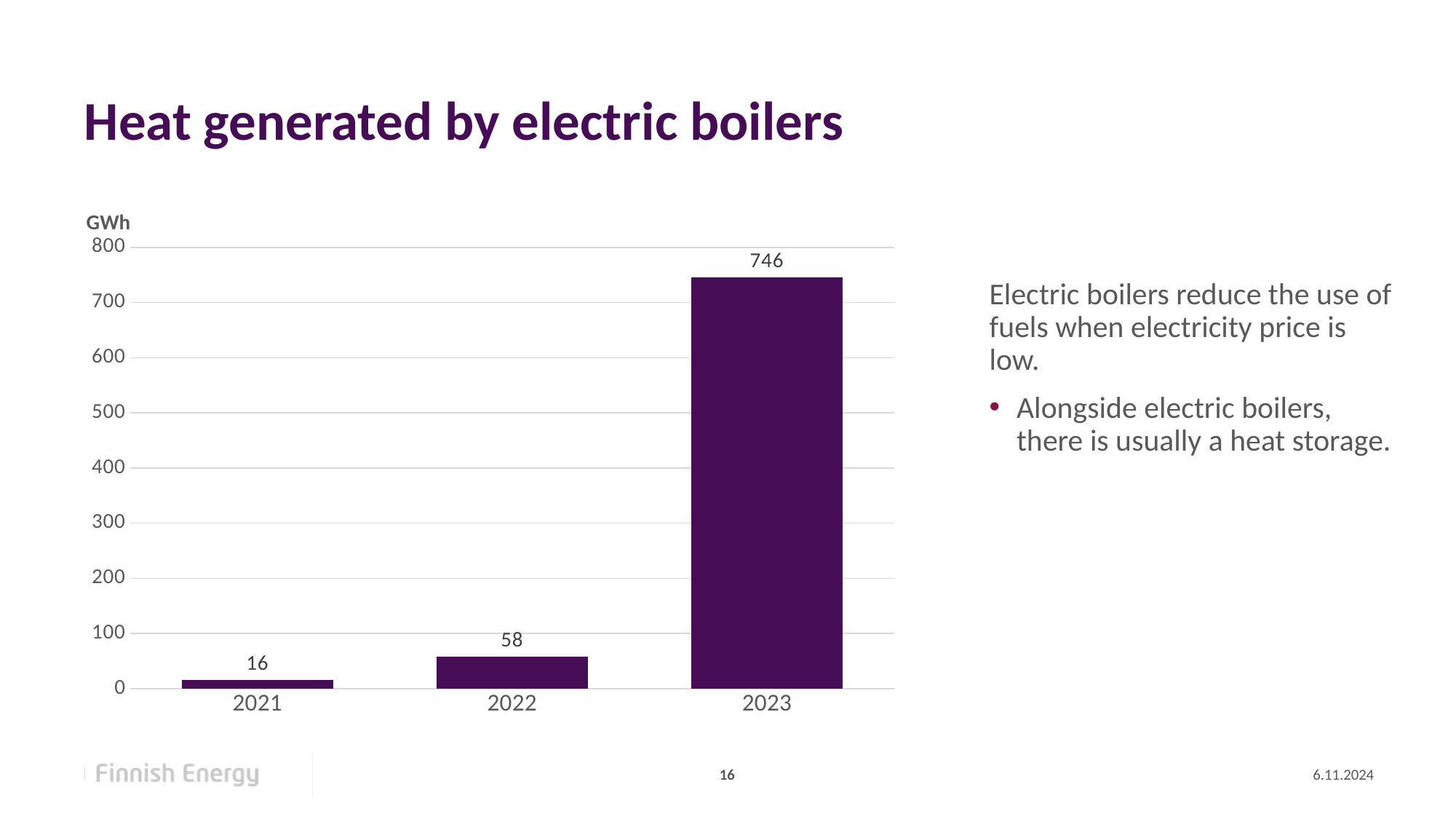
Which year had more heat generated by electric boilers, 2021 or 2022? 2022 What was the heat generated by electric boilers in 2021? 16 What is the difference in heat generated between 2023 and 2022? 688 What was the heat generated by electric boilers in 2022? 58 What is the difference in heat generated between 2022 and 2021? 42 Which year has the highest heat generated by electric boilers? 2023 Is the value for 2023 greater or less than 700? greater How many years are shown on the chart? 3 Which year has the lowest heat generated by electric boilers? 2021 What unit is shown on the chart's vertical axis? GWh What was the heat generated by electric boilers in 2023? 746 What kind of chart is shown on the slide? Bar chart